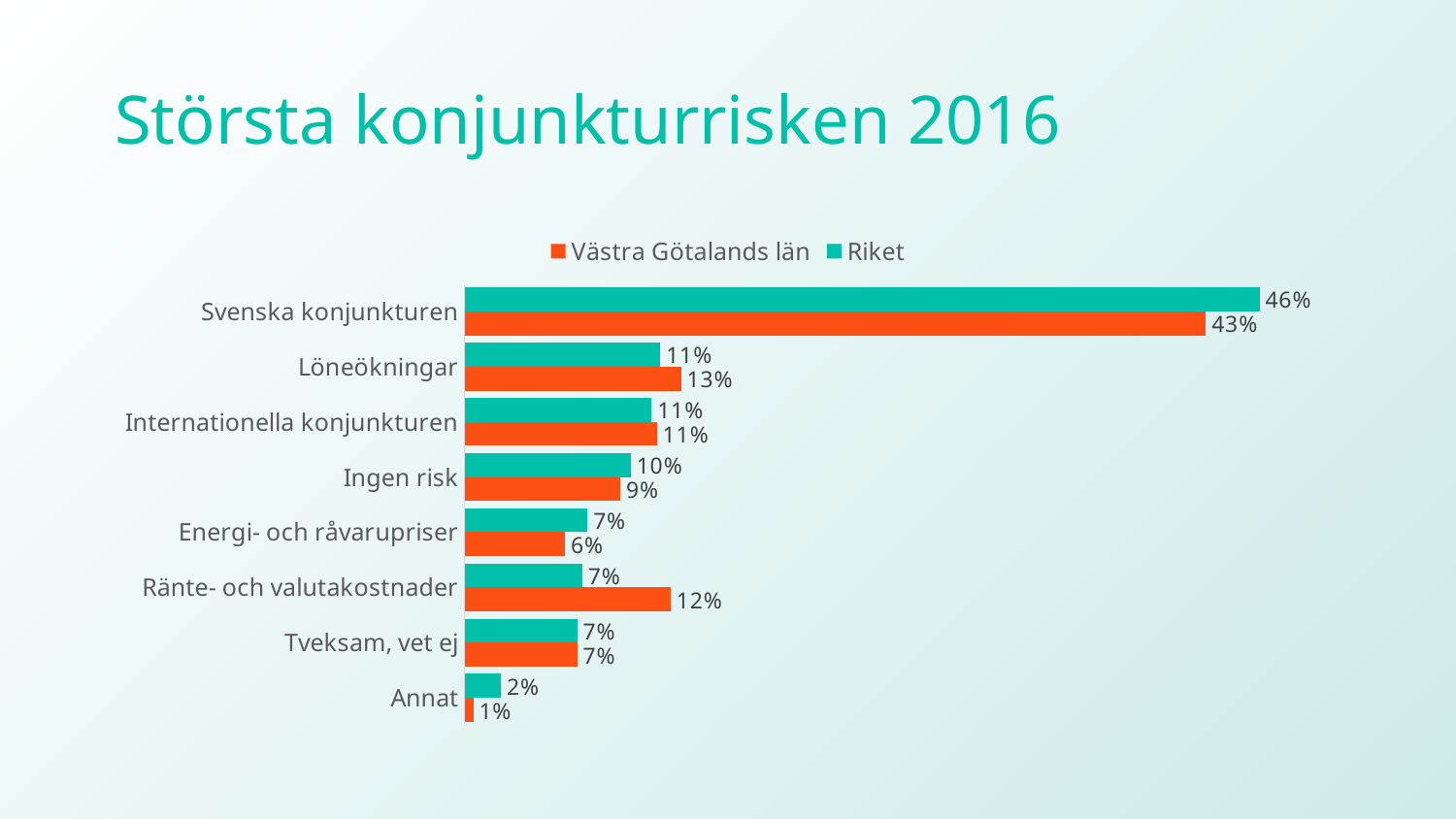
What is the value for Västra Götalands län for Ränte- och valutakostnader? 12% Which category has the highest value for Västra Götalands län? Svenska konjunkturen What is the value for Västra Götalands län for Löneökningar? 13% What is the difference between the Västra Götalands län and Riket values for Ränte- och valutakostnader? 5% Which category has the lowest value for Riket? Annat For Ingen risk, which series has the larger value, Västra Götalands län or Riket? Riket What is the value for Riket for Svenska konjunkturen? 46% What is the value for Riket for Annat? 2% How many series does the legend list? 2 What is the difference between the Riket and Västra Götalands län values for Svenska konjunkturen? 3% How many categories are shown in the chart? 8 What type of chart is shown on the slide? Bar chart